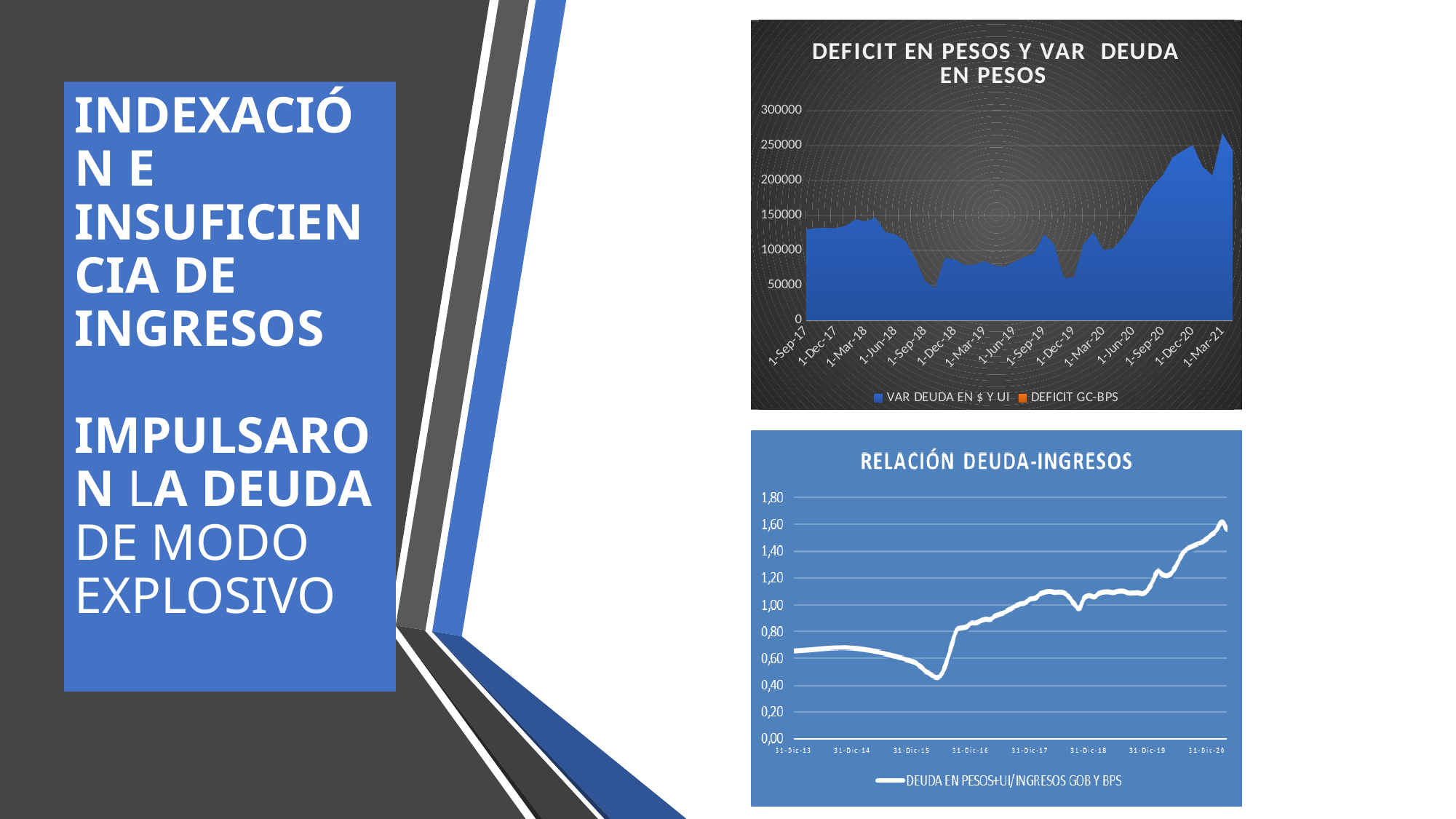
In the top chart "DEFICIT EN PESOS Y VAR DEUDA EN PESOS", do the values overall rise or fall from 1-Sep-17 to 1-Mar-21? rise How many series does the legend of the top chart "DEFICIT EN PESOS Y VAR DEUDA EN PESOS" list? 2 How many series does the legend of the bottom chart "RELACIÓN DEUDA-INGRESOS" list? 1 What type of chart is the bottom chart titled "RELACIÓN DEUDA-INGRESOS"? Line chart What type of chart is the top chart titled "DEFICIT EN PESOS Y VAR DEUDA EN PESOS"? Area chart In the top chart "DEFICIT EN PESOS Y VAR DEUDA EN PESOS", what are the two legend entries? VAR DEUDA EN $ Y UI and DEFICIT GC-BPS In the top chart "DEFICIT EN PESOS Y VAR DEUDA EN PESOS", is the value at 1-Mar-21 greater or less than 200000? greater In the bottom chart "RELACIÓN DEUDA-INGRESOS", is the value at 31-Dic-20 greater or less than 1,40? greater In the bottom chart "RELACIÓN DEUDA-INGRESOS", what is the legend entry for the plotted line? DEUDA EN PESOS+UI/INGRESOS GOB Y BPS In the bottom chart "RELACIÓN DEUDA-INGRESOS", is the value at 31-Dic-13 greater or less than 0,80? less In the bottom chart "RELACIÓN DEUDA-INGRESOS", do the values overall rise or fall from 31-Dic-13 to 31-Dic-20? rise